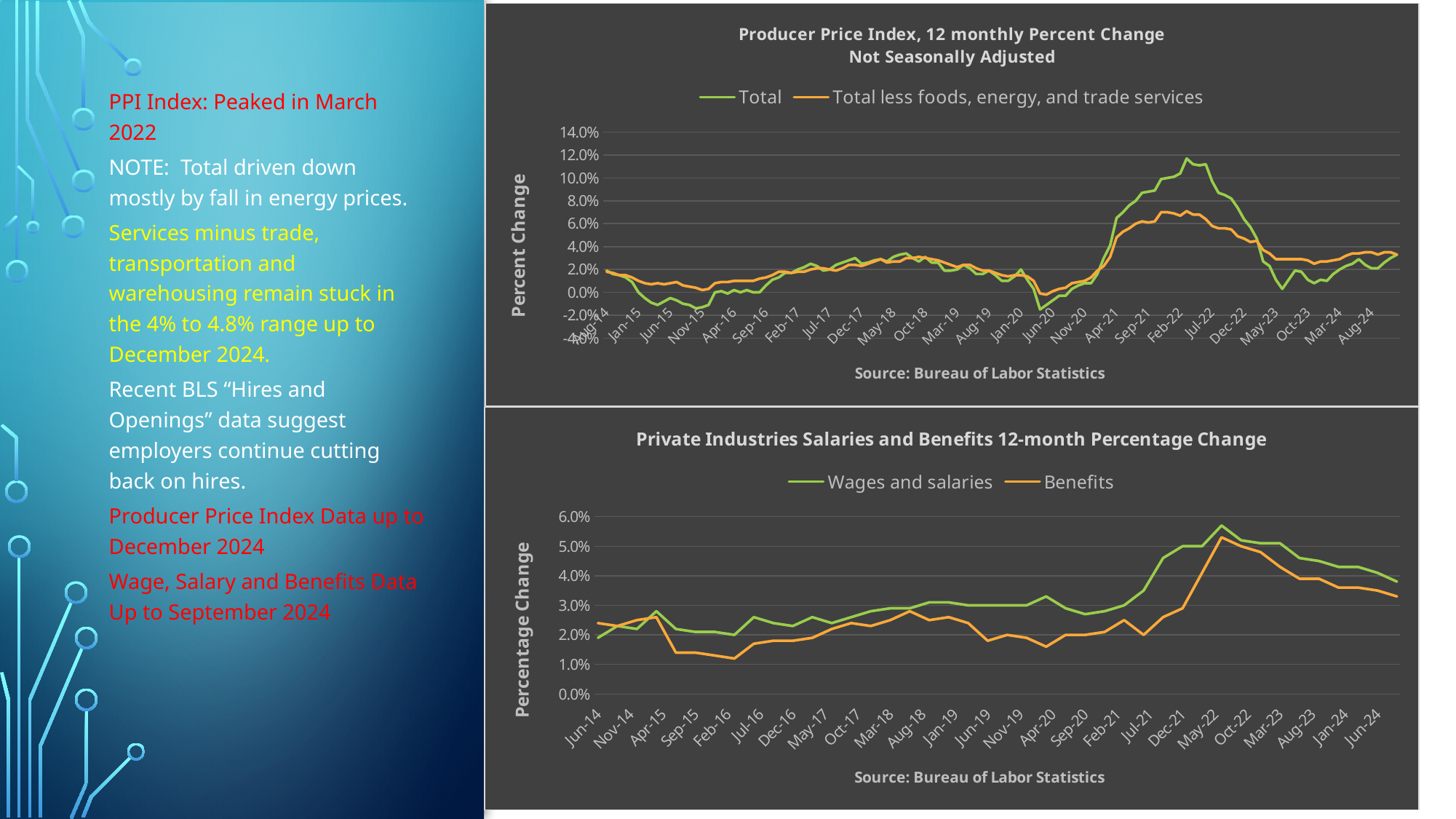
In the top chart (Producer Price Index), which series is higher around Jun-15: Total or Total less foods, energy, and trade services? Total less foods, energy, and trade services In the top chart (Producer Price Index), is the value of the Total series around Jun-20 greater or less than 0.0%? less What type of chart is the bottom chart titled 'Private Industries Salaries and Benefits 12-month Percentage Change'? Line chart What type of chart is the top chart titled 'Producer Price Index, 12 monthly Percent Change Not Seasonally Adjusted'? Line chart In the bottom chart (Private Industries Salaries and Benefits), is the value of the Benefits series around Feb-16 greater or less than 2.0%? less How many series does the legend of the top chart (Producer Price Index) list? 2 In the top chart (Producer Price Index), what are the two series named in the legend? Total; Total less foods, energy, and trade services In the bottom chart (Private Industries Salaries and Benefits), is the peak value of the Wages and salaries series around May-22 greater or less than 5.0%? greater How many series does the legend of the bottom chart (Private Industries Salaries and Benefits) list? 2 In the bottom chart (Private Industries Salaries and Benefits), does the Wages and salaries series rise or fall from Mar-23 to Jun-24? Fall In the top chart (Producer Price Index), which series reaches the higher peak in 2022? Total